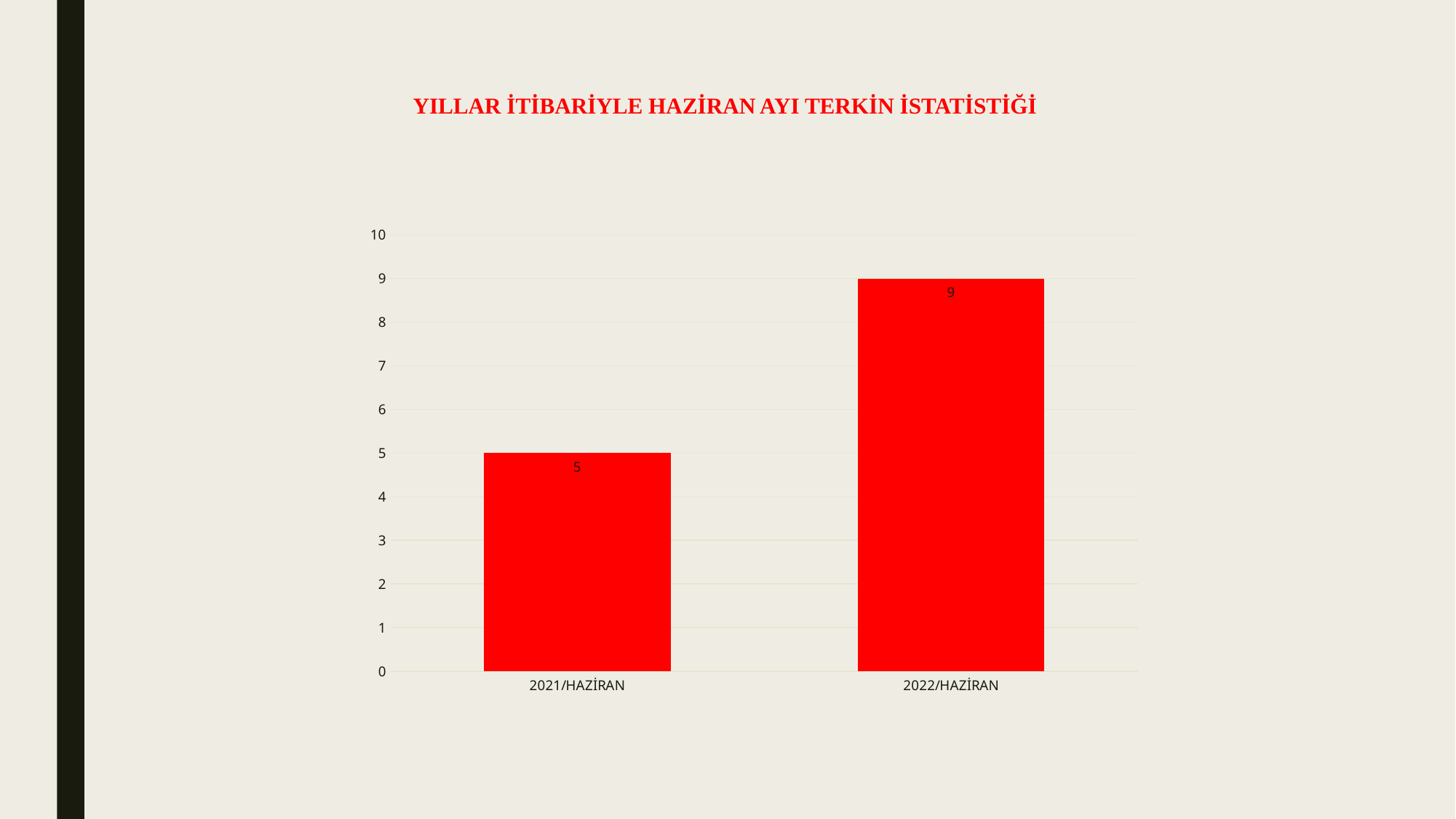
How many categories are shown on the x axis? 2 Is the value for 2022/HAZİRAN greater or less than 7? greater What is the value for 2022/HAZİRAN? 9 What kind of chart is shown on the slide? bar chart Which category has the lowest value? 2021/HAZİRAN What is the title of the chart? YILLAR İTİBARİYLE HAZİRAN AYI TERKİN İSTATİSTİĞİ Do the values rise or fall from 2021/HAZİRAN to 2022/HAZİRAN? rise Which category has the highest value? 2022/HAZİRAN Which is larger, the value for 2021/HAZİRAN or the value for 2022/HAZİRAN? 2022/HAZİRAN What is the difference between the values for 2022/HAZİRAN and 2021/HAZİRAN? 4 Is the value for 2021/HAZİRAN greater or less than 6? less What is the value for 2021/HAZİRAN? 5